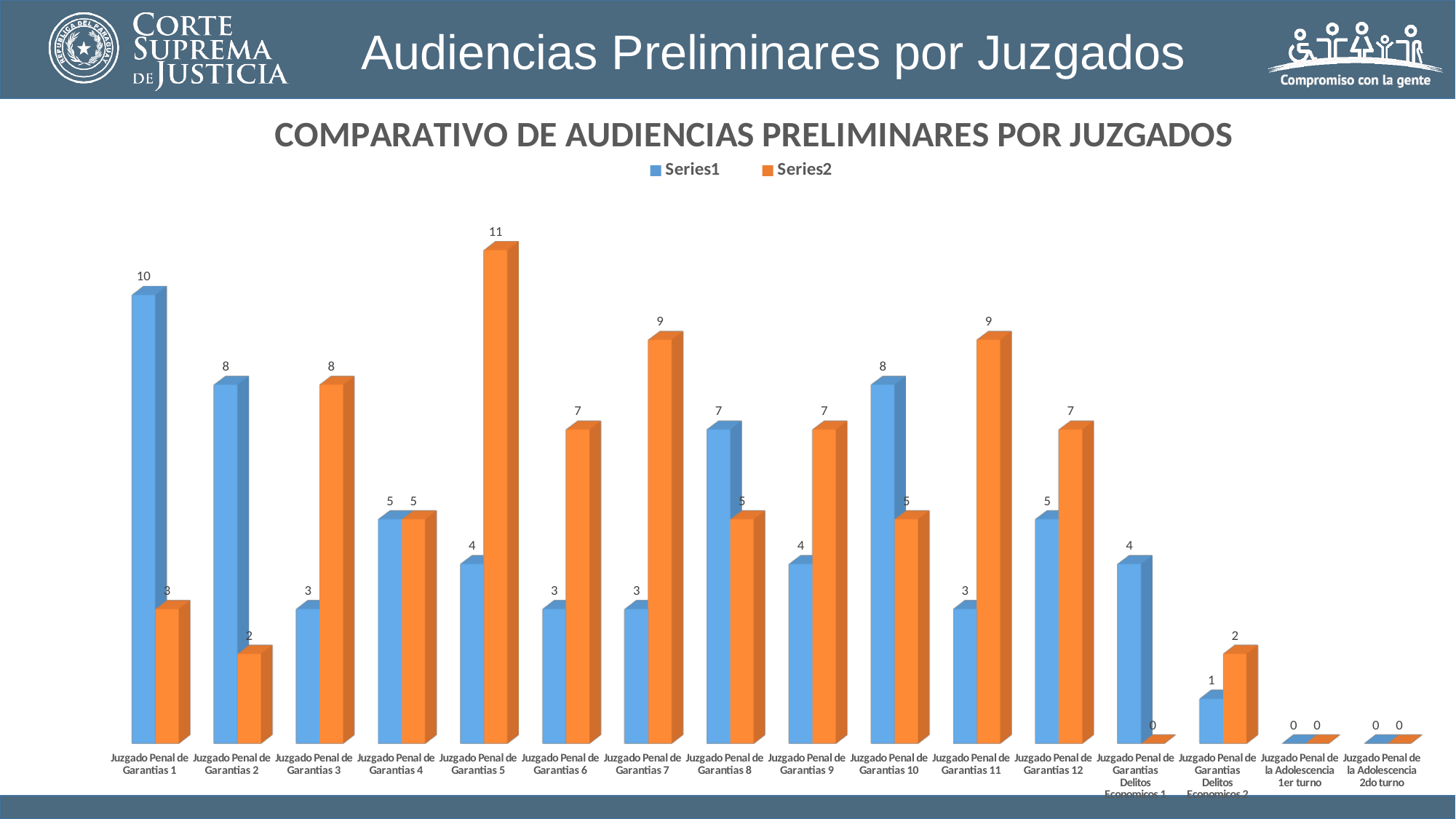
What is the Series1 value for Juzgado Penal de Garantias Delitos Economicos 2? 1 How many series does the legend list? 2 Which category has the highest Series2 value? Juzgado Penal de Garantias 5 What is the difference between the Series2 and Series1 values for Juzgado Penal de Garantias 5? 7 Which category has the highest Series1 value? Juzgado Penal de Garantias 1 What type of chart is shown on the slide? bar chart What is the Series1 value for Juzgado Penal de Garantias 1? 10 What is the Series2 value for Juzgado Penal de Garantias 5? 11 For Juzgado Penal de Garantias 3, which is larger, Series1 or Series2? Series2 What is the Series2 value for Juzgado Penal de Garantias 11? 9 What is the title of the chart? COMPARATIVO DE AUDIENCIAS PRELIMINARES POR JUZGADOS For Juzgado Penal de Garantias 8, which is larger, Series1 or Series2? Series1